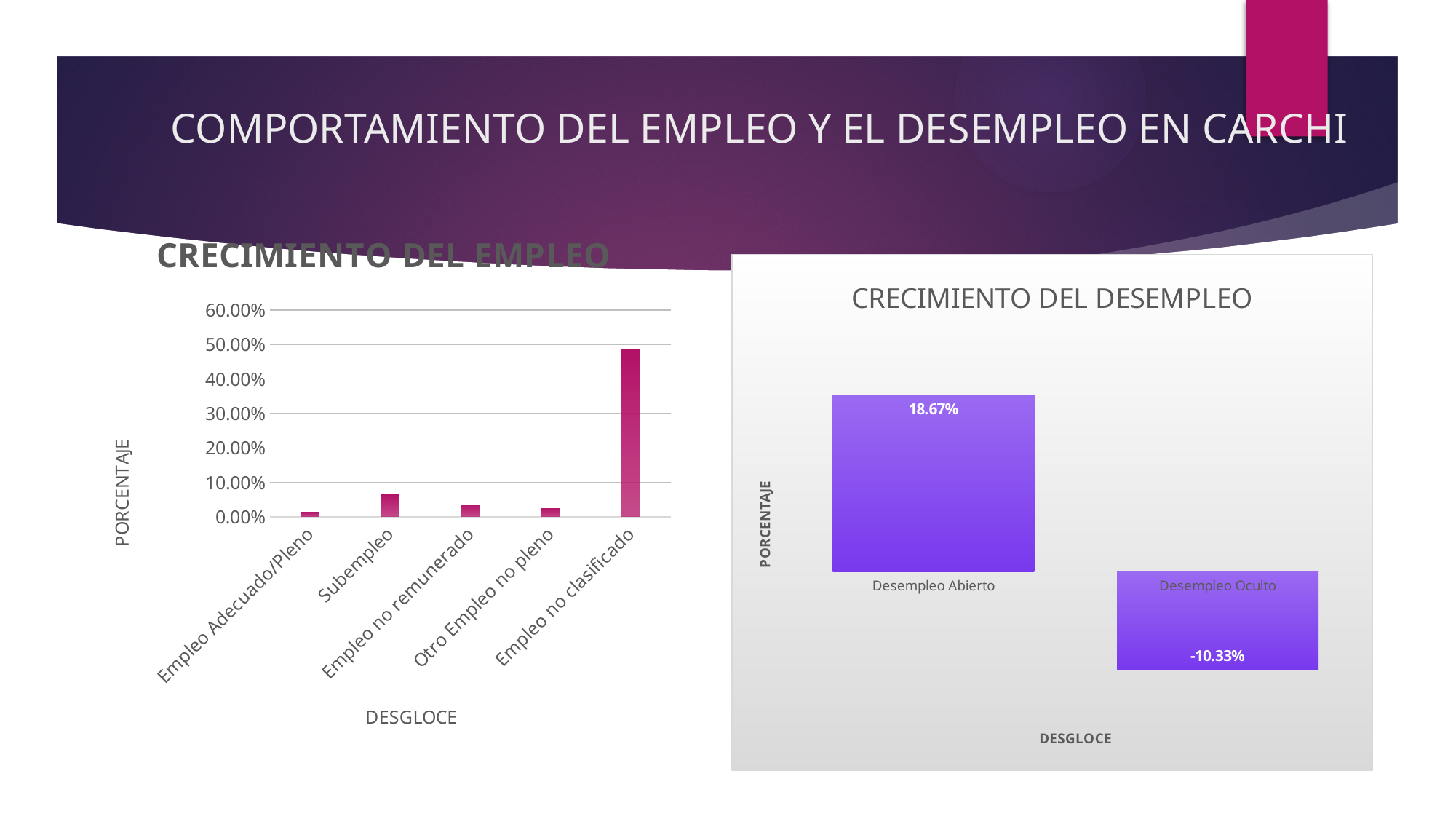
How many categories are shown in the CRECIMIENTO DEL DESEMPLEO chart? 2 What type of chart is the CRECIMIENTO DEL EMPLEO chart? bar chart In the CRECIMIENTO DEL EMPLEO chart, is the value for Subempleo greater or less than 10.00%? less In the CRECIMIENTO DEL EMPLEO chart, which is larger, Subempleo or Empleo Adecuado/Pleno? Subempleo In the CRECIMIENTO DEL DESEMPLEO chart, what is the value for Desempleo Oculto? -10.33% In the CRECIMIENTO DEL DESEMPLEO chart, which category has the higher value? Desempleo Abierto In the CRECIMIENTO DEL DESEMPLEO chart, what is the difference between Desempleo Abierto and Desempleo Oculto? 29.00% In the CRECIMIENTO DEL DESEMPLEO chart, what is the value for Desempleo Abierto? 18.67% What is the label of the vertical axis in the CRECIMIENTO DEL EMPLEO chart? PORCENTAJE In the CRECIMIENTO DEL EMPLEO chart, is the value for Empleo no clasificado greater or less than 40.00%? greater In the CRECIMIENTO DEL EMPLEO chart, which category has the highest value? Empleo no clasificado How many categories are shown in the CRECIMIENTO DEL EMPLEO chart? 5